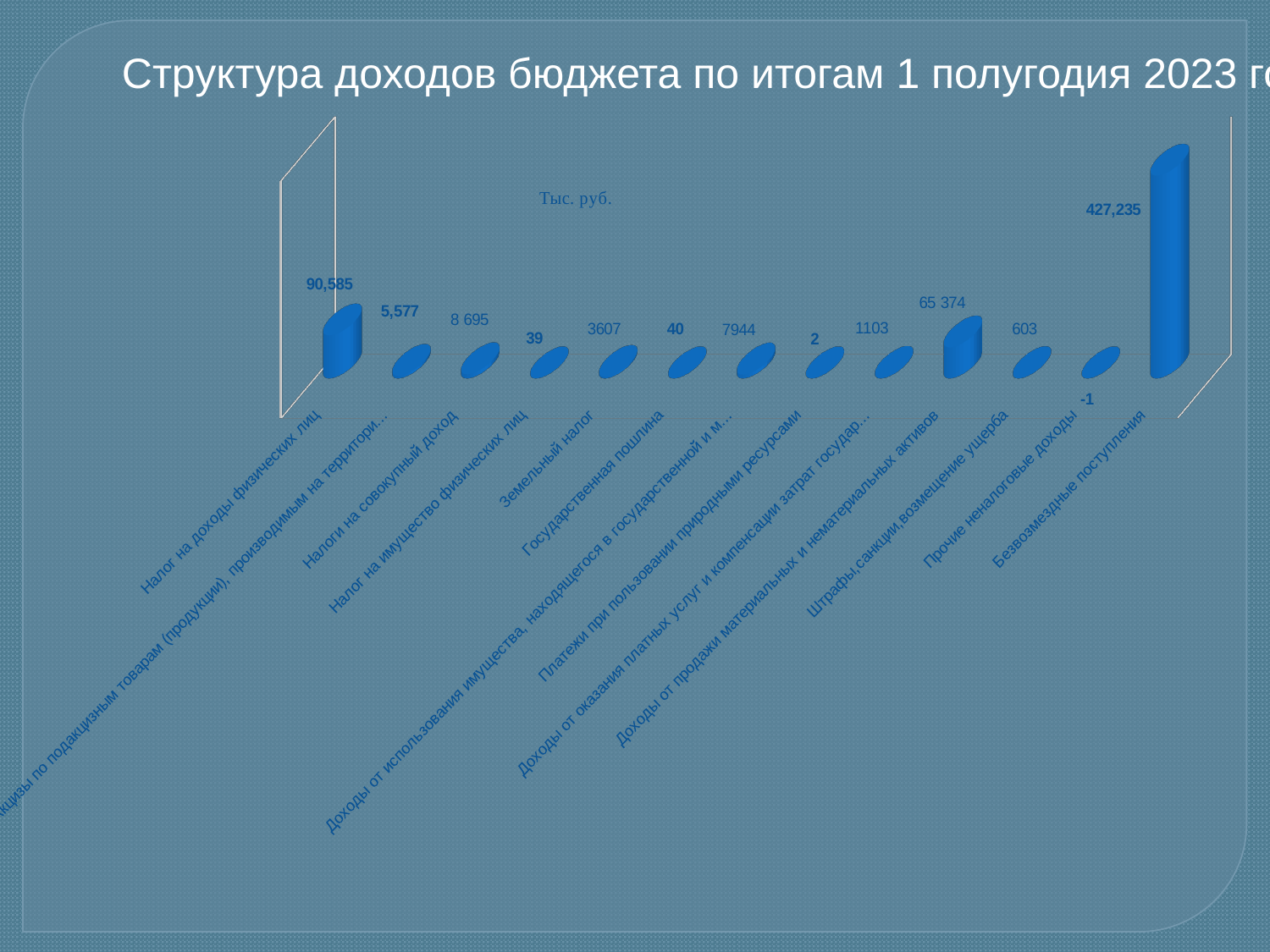
What type of chart is shown on the slide? Bar chart Which category has the highest value? Безвозмездные поступления Which is larger: the value for Налоги на совокупный доход or the value for Штрафы, санкции, возмещение ущерба? Налоги на совокупный доход What is the value for Прочие неналоговые доходы? -1 What is the value for Земельный налог? 3607 What is the difference between the values for Земельный налог and Доходы от оказания платных услуг и компенсации затрат государ...? 2504 How many categories are plotted in the chart? 13 What unit is indicated on the chart? Тыс. руб. Which category has the lowest value? Прочие неналоговые доходы What is the value for Доходы от продажи материальных и нематериальных активов? 65 374 What is the value for Налог на доходы физических лиц? 90,585 What is the value for Безвозмездные поступления? 427,235